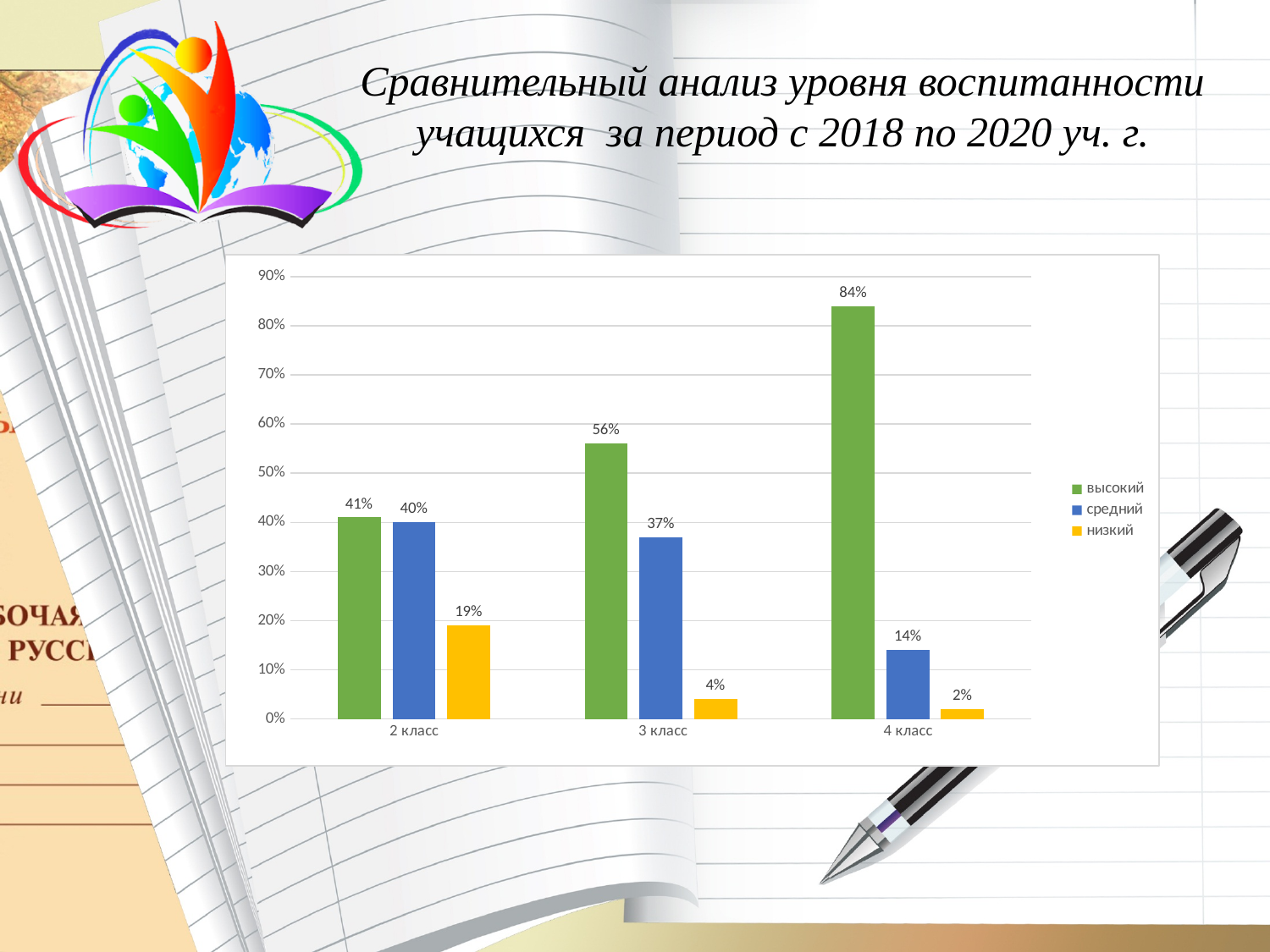
What is the value for средний in 3 класс? 37% Which category has the lowest value for низкий? 4 класс What is the value for высокий in 4 класс? 84% What is the value for низкий in 2 класс? 19% What colour are the bars for низкий? yellow Which category has the highest value for высокий? 4 класс How many series does the legend list? 3 Do the values for высокий rise or fall from 2 класс to 4 класс? rise What kind of chart is shown on the slide? bar chart Which is larger in 2 класс: высокий or средний? высокий What is the difference between высокий and средний in 4 класс? 70% How many categories are shown on the x axis? 3